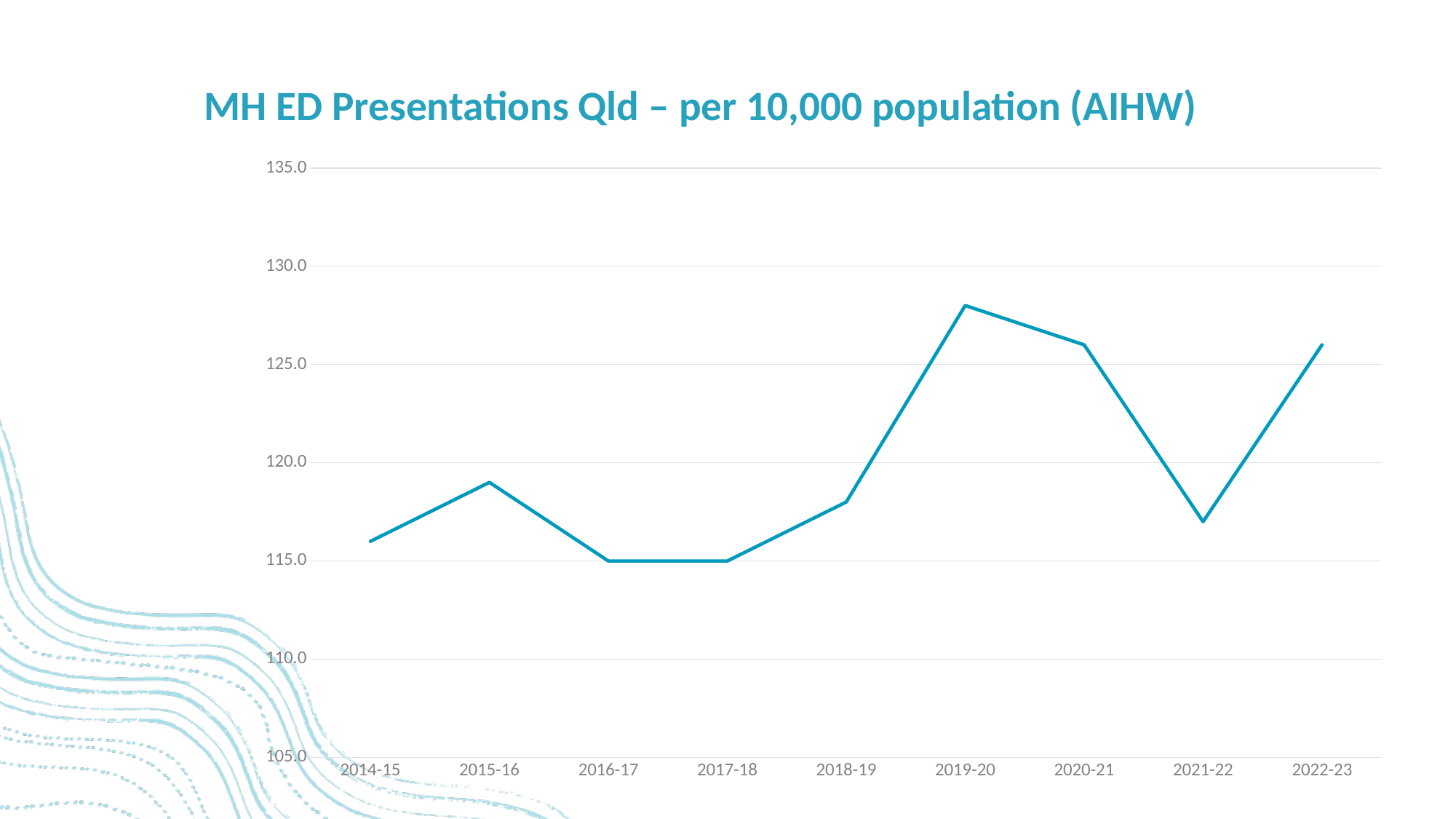
What is the title of the chart? MH ED Presentations Qld – per 10,000 population (AIHW) What kind of chart is shown on the slide? line chart What is the value for 2017-18? 115.0 How many financial years are plotted on the x axis? 9 Is the value for 2022-23 greater or less than 125.0? greater Which year has the highest value? 2019-20 Is the value for 2019-20 greater or less than 125.0? greater Do the values rise or fall from 2017-18 to 2019-20? rise What is the value for 2016-17? 115.0 Which is larger, the value for 2019-20 or the value for 2014-15? 2019-20 Is the value for 2014-15 greater or less than 120.0? less